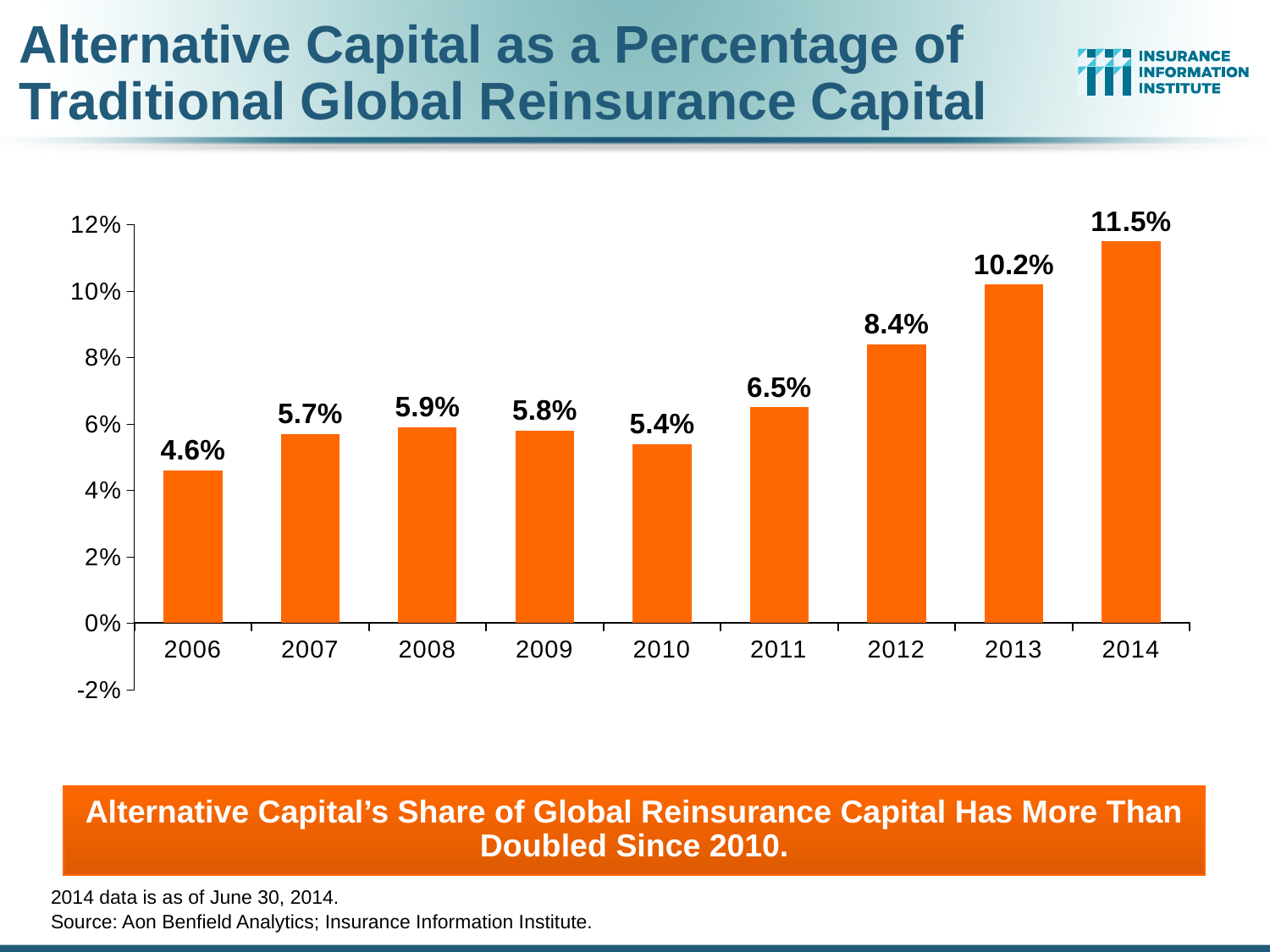
What is the difference between the values for 2014 and 2013? 1.3% Do the values rise or fall from 2010 to 2014? Rise What kind of chart is shown on the slide? Bar chart What is the difference between the values for 2012 and 2010? 3.0% Which year has the lowest value? 2006 What is the value for 2010? 5.4% Which year has the highest value? 2014 What is the value for 2014? 11.5% What is the value for 2007? 5.7% How many years are shown on the chart? 9 Is the value for 2013 greater or less than 10%? greater Which is larger, the value for 2008 or the value for 2010? 2008